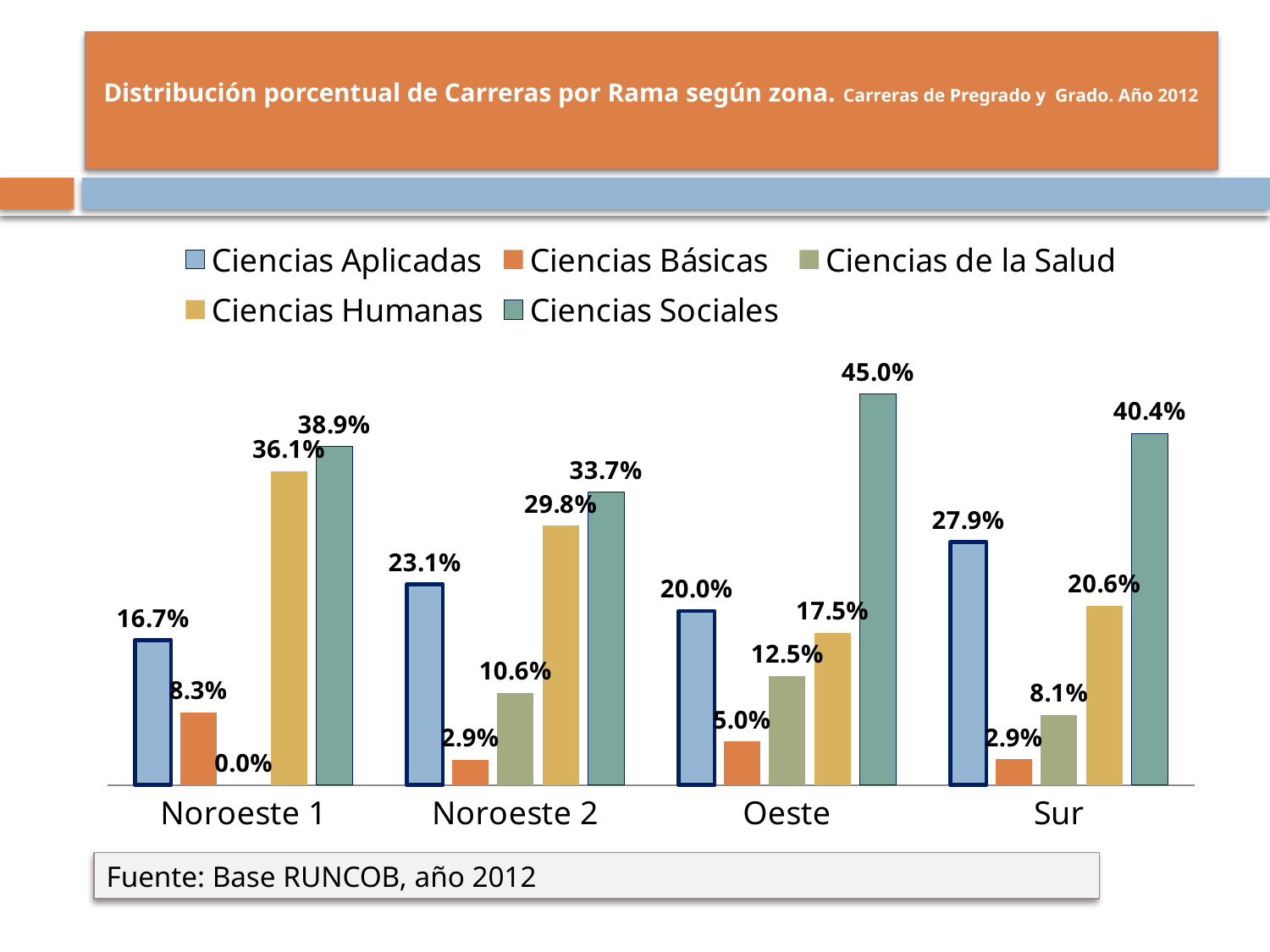
What is the value for Ciencias Sociales in Oeste? 45.0% What is the difference between Ciencias Sociales and Ciencias Aplicadas in Sur? 12.5% Which zone has the highest value for Ciencias Sociales? Oeste What is the value for Ciencias Humanas in Noroeste 1? 36.1% Which zone has the lowest value for Ciencias de la Salud? Noroeste 1 What kind of chart is shown on the slide? Bar chart How many series does the legend list? 5 How many zones are shown on the x axis? 4 Which is larger in Oeste: Ciencias Humanas or Ciencias de la Salud? Ciencias Humanas What source is cited below the chart? Fuente: Base RUNCOB, año 2012 What is the value for Ciencias de la Salud in Noroeste 2? 10.6% What is the value for Ciencias Aplicadas in Sur? 27.9%